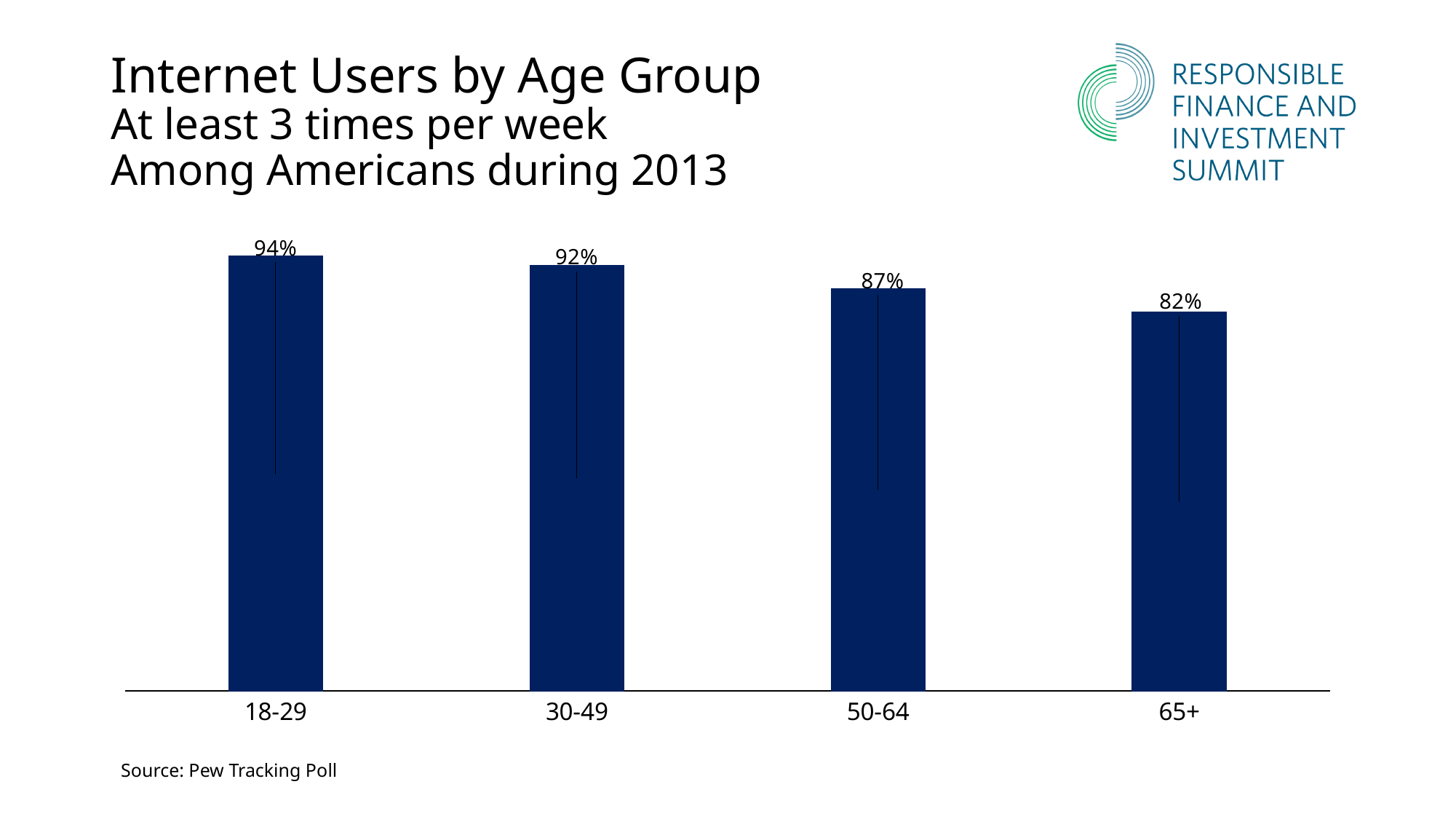
What is the value for the 18-29 age group? 94% What is the value for the 65+ age group? 82% What is the difference between the values for the 30-49 and 50-64 age groups? 5% What is the value for the 50-64 age group? 87% What kind of chart is shown on the slide? Bar chart Which age group has the highest value? 18-29 Which is larger, the value for 50-64 or the value for 65+? 50-64 Do the values rise or fall as age group increases along the x axis? Fall Which age group has the lowest value? 65+ What is the value for the 30-49 age group? 92% What is the difference between the values for the 18-29 and 65+ age groups? 12% How many age groups are shown on the chart? 4